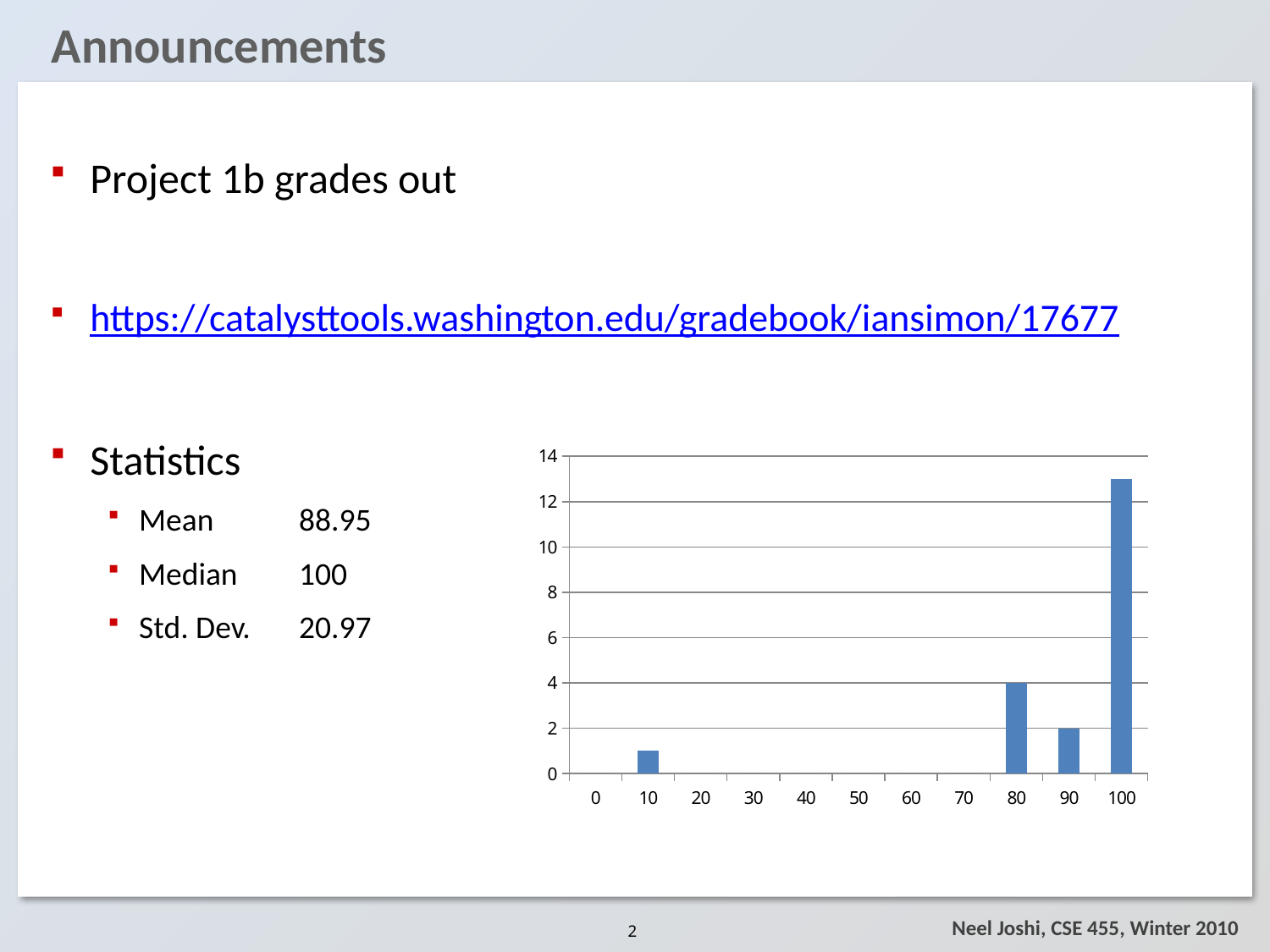
What is the highest value labelled on the y axis of the chart? 14 Is the value for 80 in the chart greater or less than 2? greater What is the value of the bar at 90 in the chart? 2 What is the value of the bar at 80 in the chart? 4 Which x-axis category has the tallest bar in the chart? 100 Is the value for 100 in the chart greater or less than 12? greater Is the value for 10 in the chart greater or less than 2? less Which bar is taller in the chart, the one at 10 or the one at 100? 100 What is the difference between the bar at 80 and the bar at 90 in the chart? 2 How many categories are labelled on the x axis of the chart? 11 Which bar is taller in the chart, the one at 80 or the one at 90? 80 What kind of chart is shown on the slide? bar chart